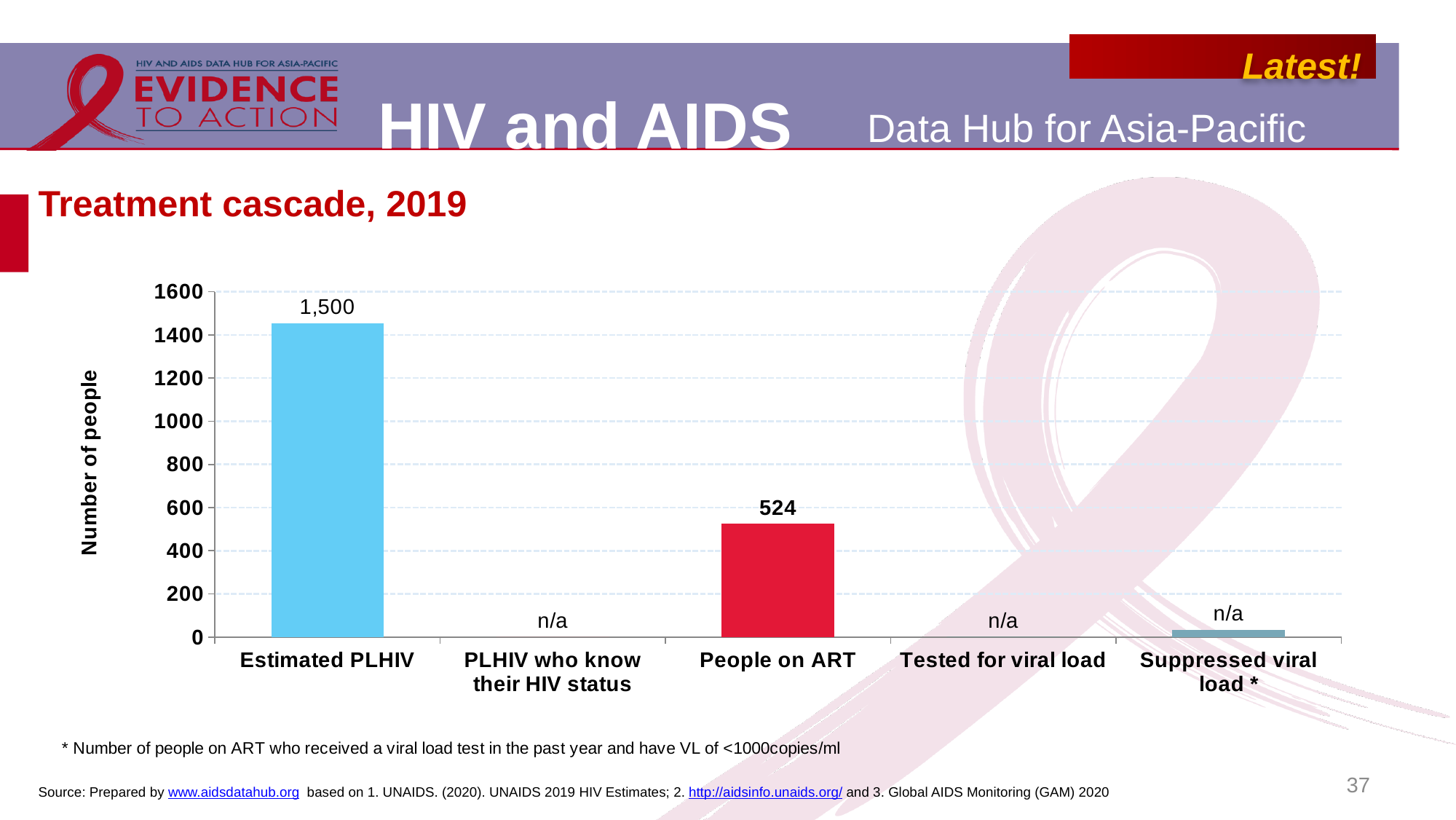
What is the label of the y axis? Number of people What kind of chart is this? Bar chart Is the value for People on ART greater or less than 600? less Which is larger, Estimated PLHIV or People on ART? Estimated PLHIV What is shown as the value for PLHIV who know their HIV status? n/a How many categories are shown on the x axis? 5 What is shown as the value for Tested for viral load? n/a What is the value for People on ART? 524 What is the value for Estimated PLHIV? 1,500 Which category has the highest value? Estimated PLHIV What is the difference between Estimated PLHIV and People on ART? 976 What is the title of the chart? Treatment cascade, 2019